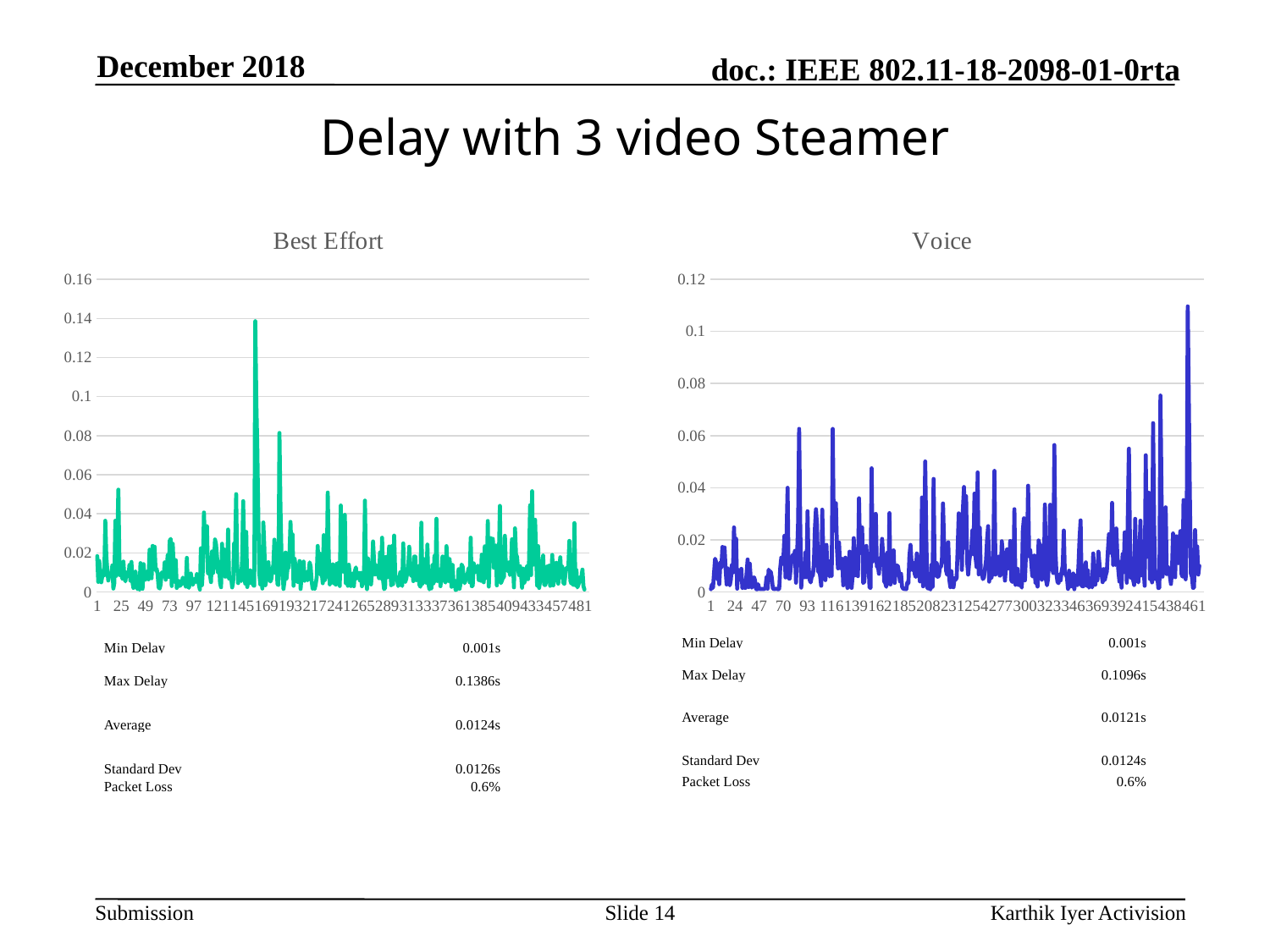
What is the difference between the Max Delay of Best Effort and the Max Delay of Voice? 0.0290s What kind of chart is the Voice chart? line chart In the Voice chart, is the highest peak greater or less than 0.12? less What is the Max Delay listed under the Voice chart? 0.1096s In the Best Effort chart, is the highest peak greater or less than 0.12? greater In the Voice chart, is the highest peak greater or less than 0.1? greater What is the highest value shown on the y axis of the Best Effort chart? 0.16 What is the title of the chart on the right side of the slide? Voice Which chart has the higher peak delay, Best Effort or Voice? Best Effort What kind of chart is the Best Effort chart? line chart What is the Average delay listed under the Voice chart? 0.0121s What is the Max Delay listed under the Best Effort chart? 0.1386s